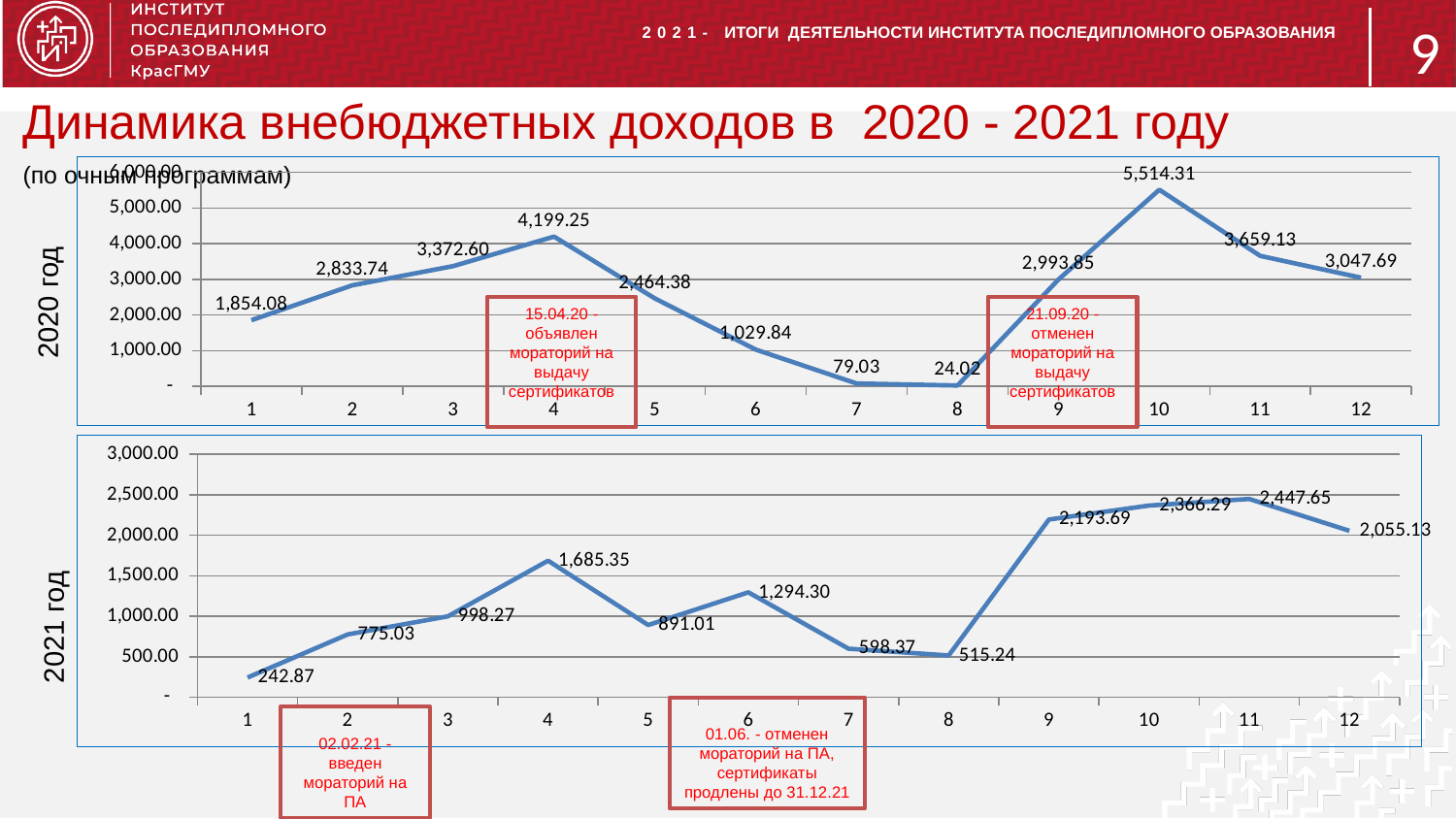
On the 2021 год chart, which is larger, the value for month 6 or the value for month 5? month 6 On the 2021 год chart, which month has the lowest value? 1 On the 2020 год chart, which month has the highest value? 10 On the 2020 год chart, what is the value for month 10? 5,514.31 On the 2020 год chart, which month has the lowest value? 8 On the 2021 год chart, what is the difference between the values for month 12 and month 1? 1,812.26 On the 2020 год chart, what is the difference between the values for month 4 and month 5? 1,734.87 On the 2020 год chart, what is the value for month 1? 1,854.08 How many months are plotted on the 2021 год chart? 12 On the 2021 год chart, what is the value for month 4? 1,685.35 What type of chart is the 2020 год chart? line chart On the 2021 год chart, which month has the highest value? 11